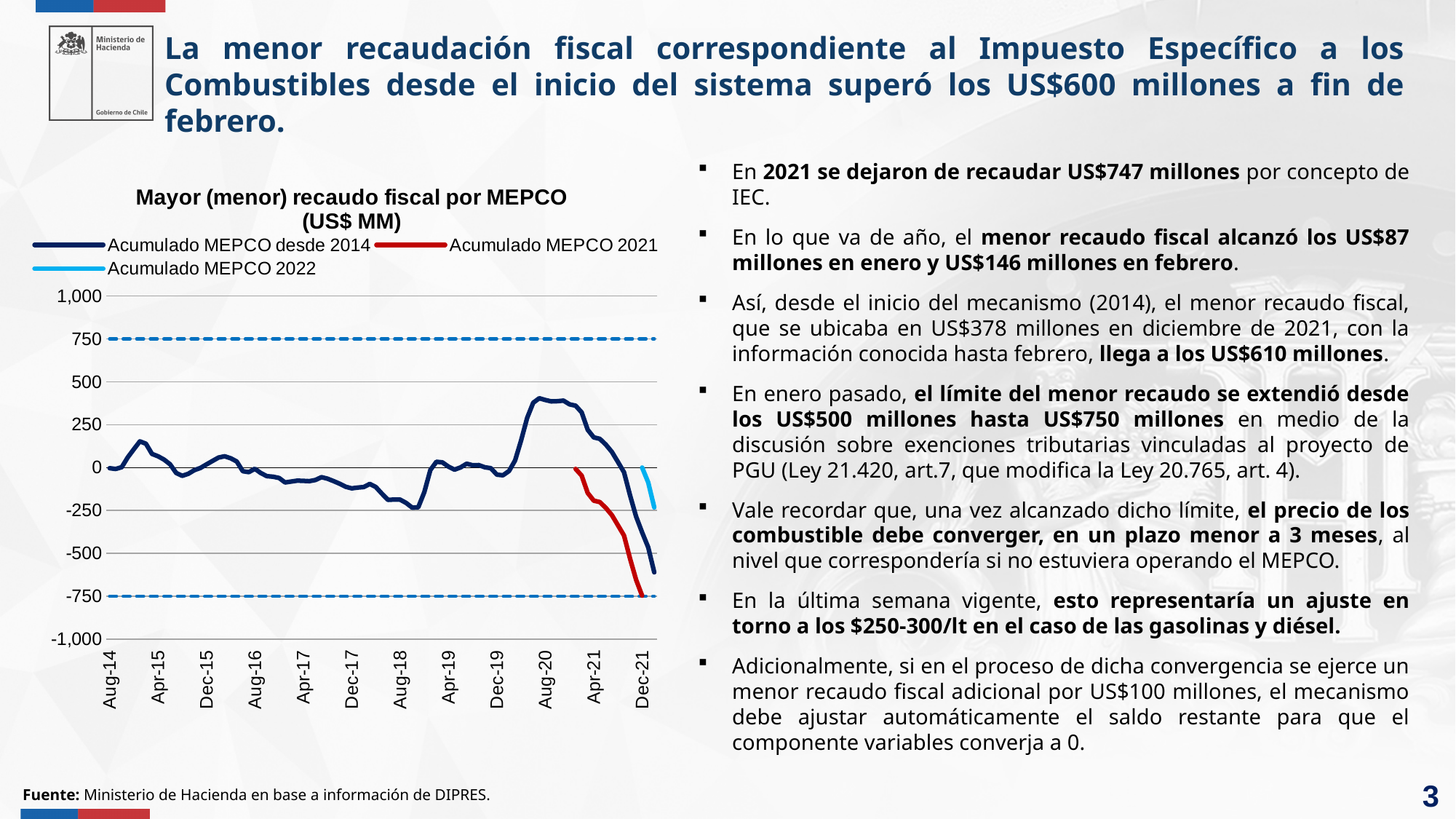
Does the Acumulado MEPCO 2021 line rise or fall between Apr-21 and Dec-21? fall What kind of chart is shown on the slide? line chart Is the value of the Acumulado MEPCO desde 2014 line at Dec-21 greater or less than -500? greater Which series in the chart is drawn in red? Acumulado MEPCO 2021 Is the value of the Acumulado MEPCO desde 2014 line at Aug-20 greater or less than 250? greater Around which x-axis label does the Acumulado MEPCO desde 2014 line reach its highest value? Aug-20 Is the final value of the Acumulado MEPCO 2022 line greater or less than 0? less How many series does the legend of the chart list? 3 What is the title of the chart? Mayor (menor) recaudo fiscal por MEPCO (US$ MM) At Dec-21, which line is lower: Acumulado MEPCO desde 2014 or Acumulado MEPCO 2021? Acumulado MEPCO 2021 How many labels are shown on the x axis of the chart? 12